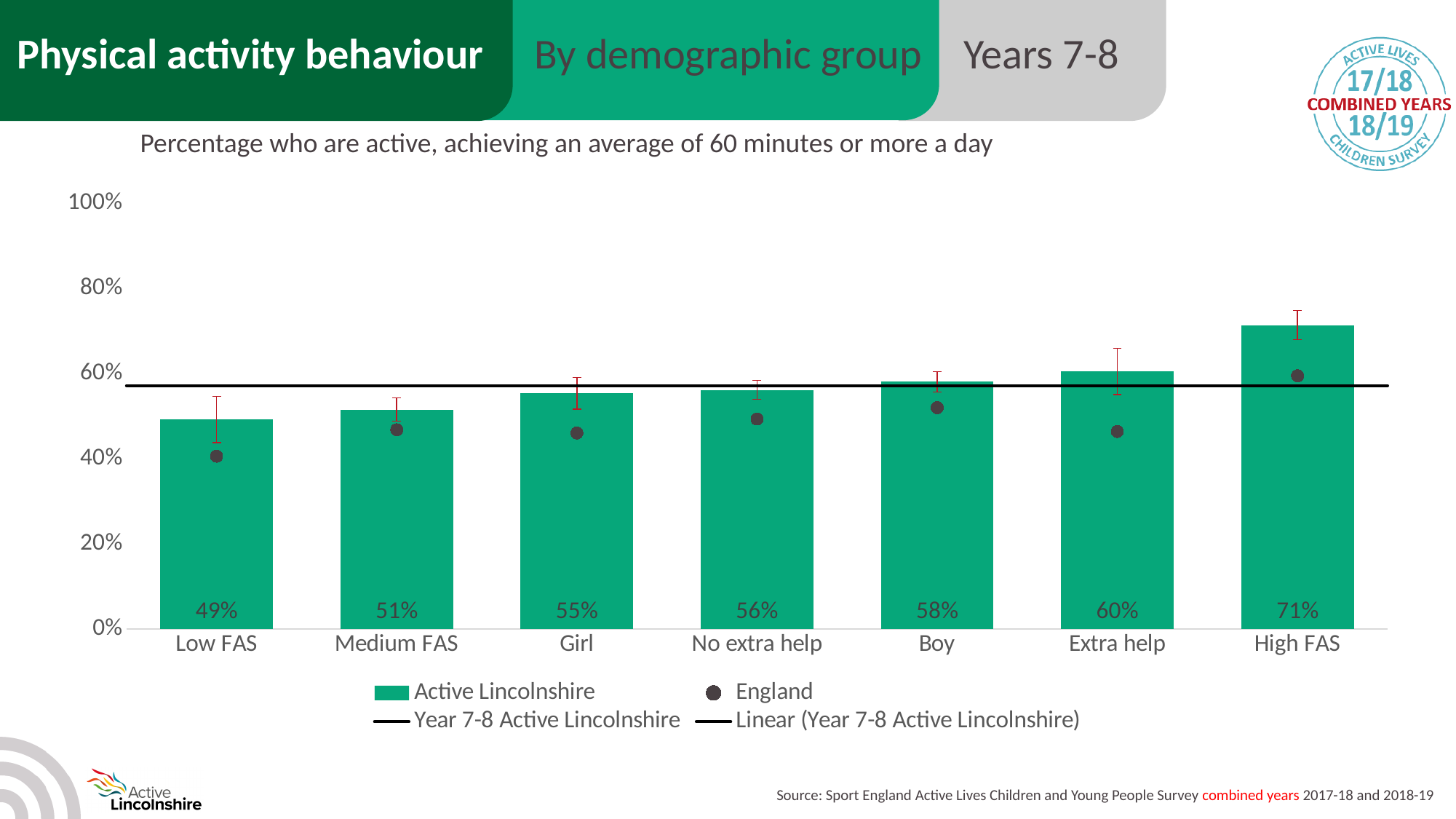
How many series does the legend list? 4 What is the Active Lincolnshire value for Extra help? 60% How many categories are shown on the x axis? 7 What kind of chart is shown on the slide? combination bar and line chart Do the Active Lincolnshire values rise or fall from Low FAS to High FAS along the x axis? rise What is the Active Lincolnshire value for Girl? 55% Which category has the highest Active Lincolnshire value? High FAS Which has a larger Active Lincolnshire value, Boy or Girl? Boy What is the difference between the Active Lincolnshire values for High FAS and Low FAS? 22% Which category has the lowest Active Lincolnshire value? Low FAS Is the England value for Low FAS greater or less than 60%? less What is the Active Lincolnshire value for Low FAS? 49%